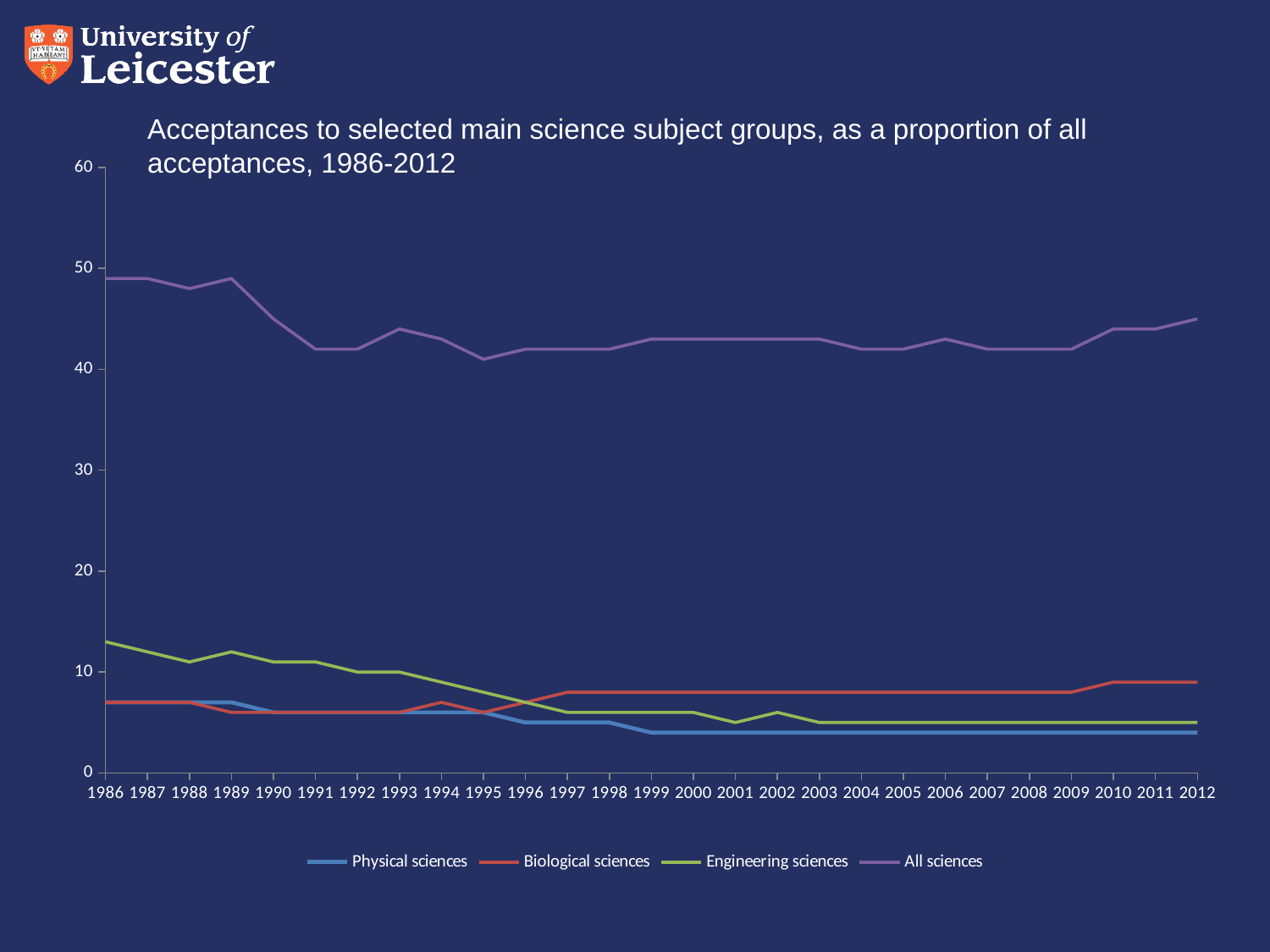
Is the value for Physical sciences in 2012 greater or less than 10? less Which series has the highest values across the whole period? All sciences Is the value for Engineering sciences in 2012 greater or less than 10? less In 1986, which is higher: Engineering sciences or Physical sciences? Engineering sciences How many years are plotted along the x axis? 27 Does the Engineering sciences line rise or fall from 1986 to 2012? fall What colour is the All sciences line? purple Is the value for Engineering sciences in 1986 greater or less than 10? greater In 2012, which is higher: Biological sciences or Physical sciences? Biological sciences How many series does the legend list? 4 What kind of chart is shown on the slide? line chart